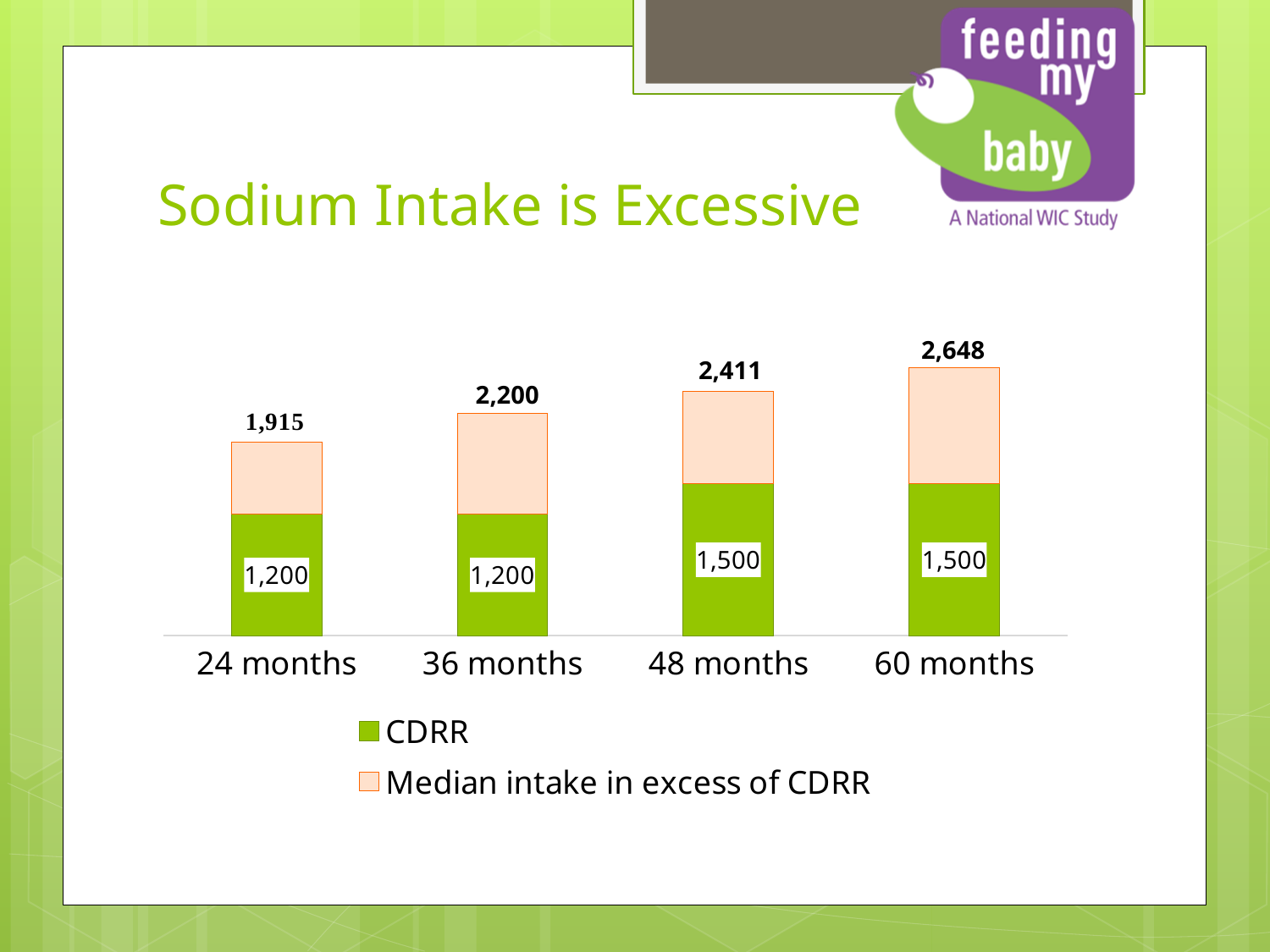
How many age categories are shown on the x axis? 4 Which age category has the lowest total bar? 24 months How many series does the legend list? 2 What is the CDRR value for 48 months? 1,500 What type of chart is shown on the slide? stacked bar chart What is the total value labeled above the bar for 36 months? 2,200 Do the total bar values rise or fall from 24 months to 60 months? rise What is the difference between the total for 60 months and the total for 24 months? 733 What is the total value labeled above the bar for 60 months? 2,648 What is the title of the chart on the slide? Sodium Intake is Excessive Which age category has the highest total bar? 60 months What is the CDRR value for 24 months? 1,200